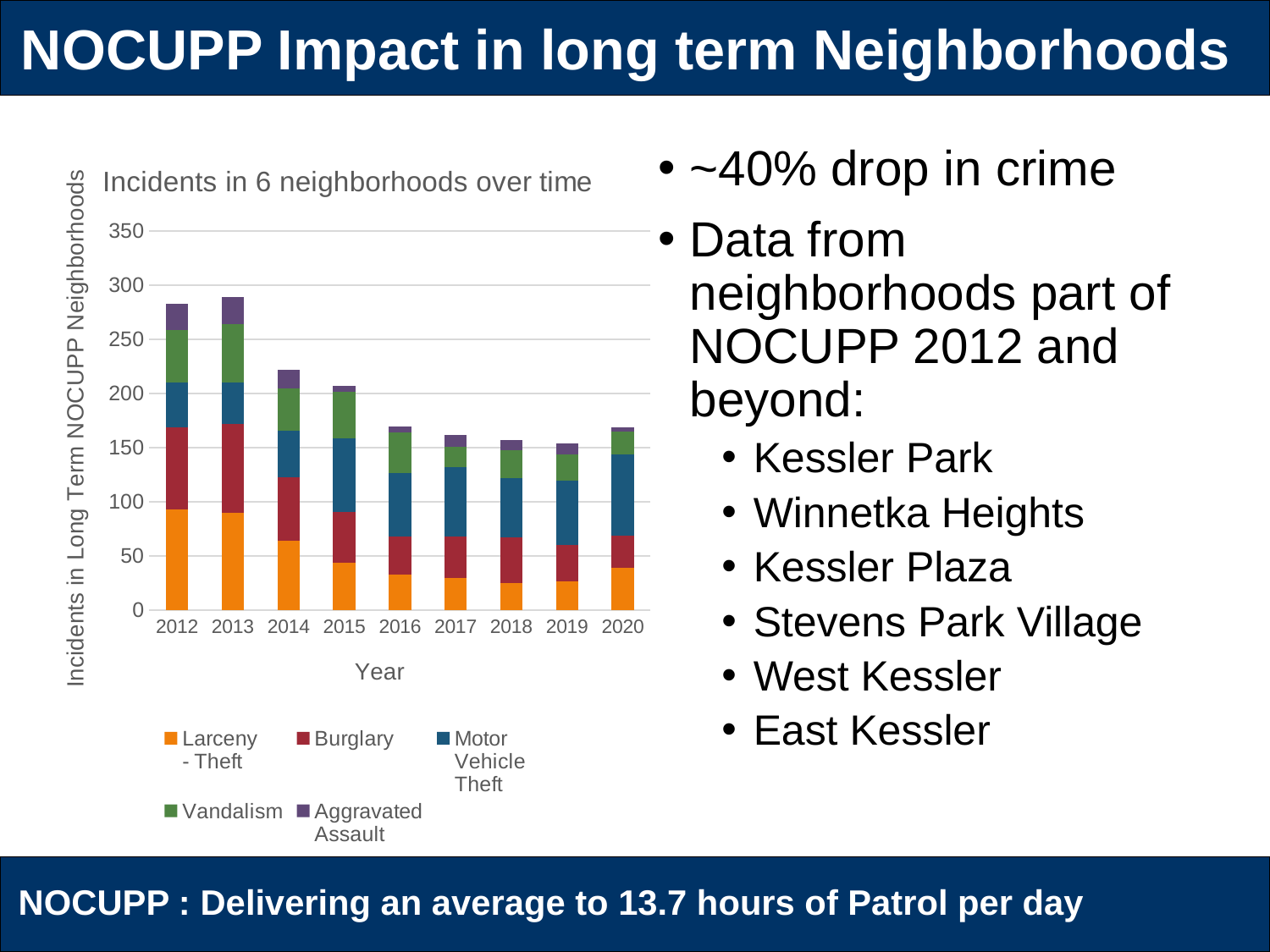
How many years are shown on the x axis of the chart? 9 Is the total number of incidents in 2020 greater or less than 200? less Which year has the larger total number of incidents, 2012 or 2016? 2012 What is the label on the x axis of the chart? Year What is the title of the chart? Incidents in 6 neighborhoods over time Is the total number of incidents in 2016 greater or less than 200? less How many series does the chart's legend list? 5 Is the Larceny - Theft value for 2018 greater or less than 50? less What kind of chart is shown on the slide? Stacked bar chart Do the total incidents generally rise or fall from 2012 to 2020? fall Which year has the larger total number of incidents, 2014 or 2019? 2014